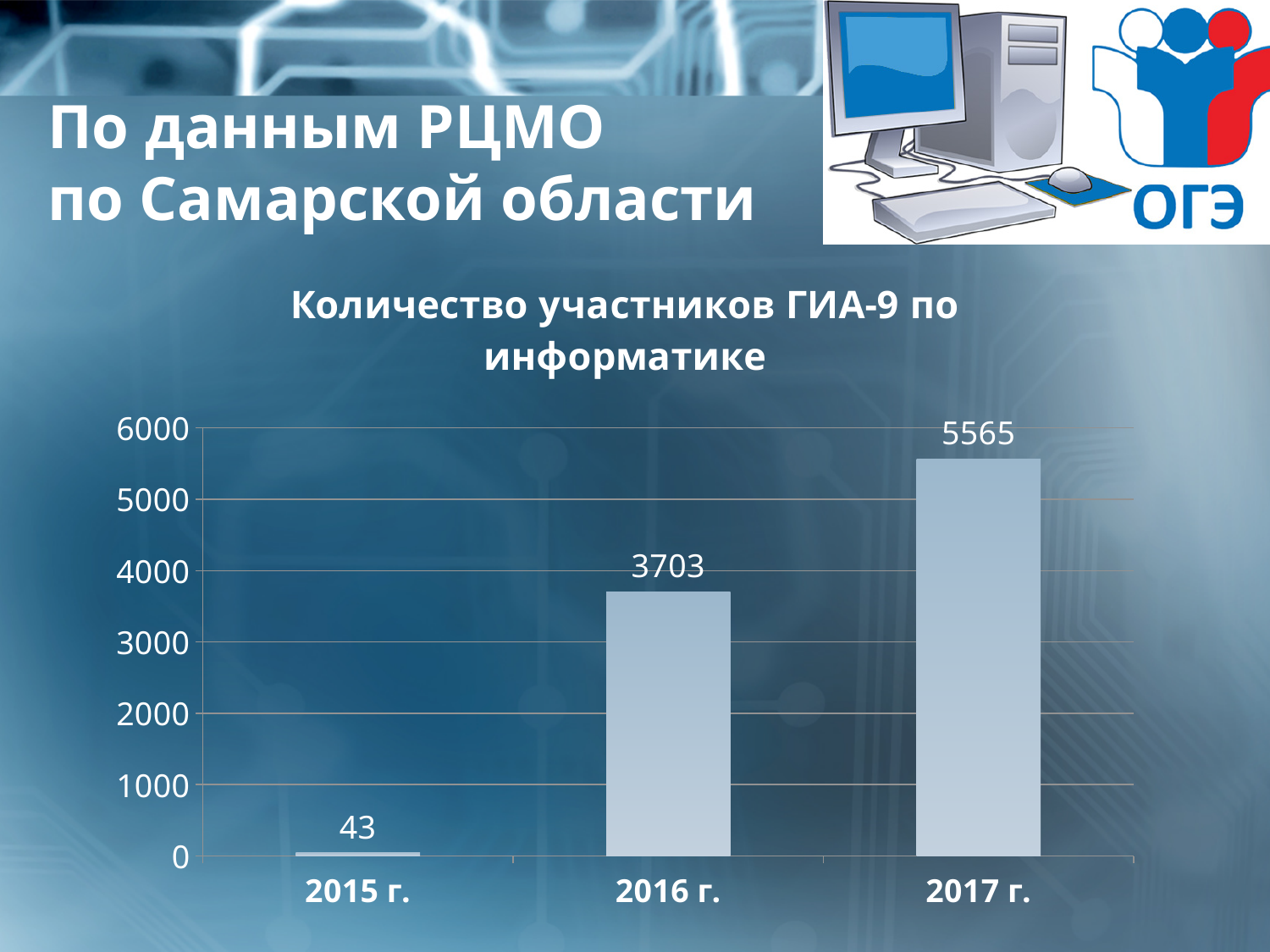
What is the difference between the values for 2016 г. and 2015 г.? 3660 What is the difference between the values for 2017 г. and 2016 г.? 1862 What is the value for 2016 г.? 3703 Is the value for 2016 г. greater or less than 4000? less Which year has the highest number of participants? 2017 г. How many categories are shown on the x axis? 3 What is the value for 2017 г.? 5565 Which year has the lowest number of participants? 2015 г. What kind of chart is shown on the slide? bar chart Do the values rise or fall from 2015 г. to 2017 г.? rise Which is larger, the value for 2016 г. or the value for 2017 г.? 2017 г. What is the value for 2015 г.? 43